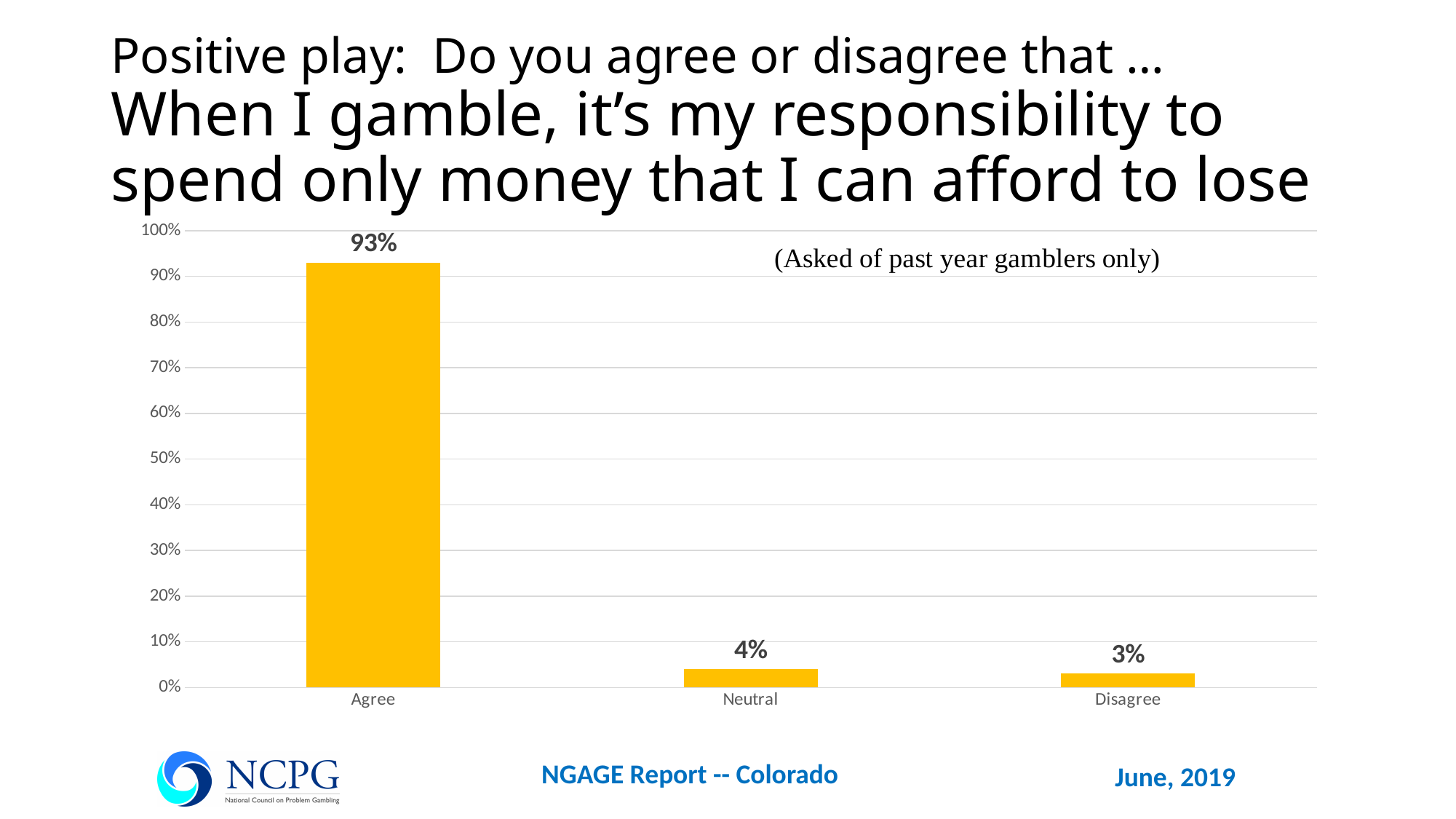
What note is printed inside the chart area about who was asked the question? (Asked of past year gamblers only) Which response category has the lowest value? Disagree What is the difference between the Agree and Disagree percentages? 90% How many response categories are shown on the x axis? 3 What type of chart is shown on the slide? Bar chart Is the value for Agree greater or less than 90%? greater Which is larger, the value for Agree or the value for Neutral? Agree What percentage of respondents chose Neutral? 4% Which response category has the highest value? Agree What percentage of respondents chose Agree? 93% What is the difference between the Neutral and Disagree percentages? 1% What percentage of respondents chose Disagree? 3%